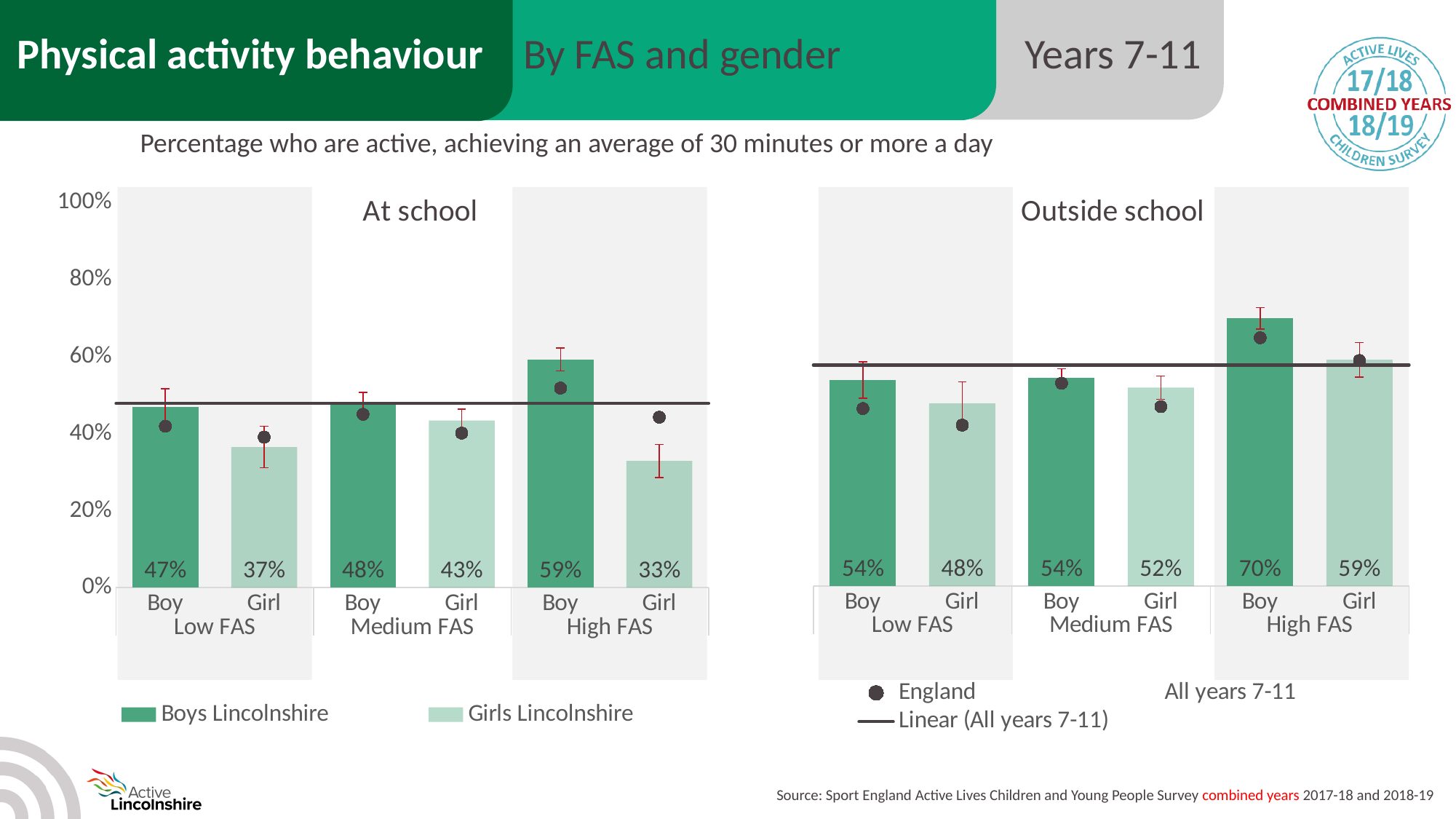
In the 'At school' chart, is the value for Medium FAS girls greater or less than 40%? greater What does the dark green bar colour represent in the legend? Boys Lincolnshire In the 'Outside school' chart, what is the difference between the Low FAS boys and Low FAS girls values? 6% What type of chart is the 'At school' chart? Bar chart In the 'Outside school' chart, which bar has the highest value? High FAS Boy In the 'Outside school' chart, which is larger: the Medium FAS boys value or the Medium FAS girls value? Medium FAS boys In the 'At school' chart, which bar has the lowest value? High FAS Girl In the 'At school' chart, what percentage of Low FAS boys in Lincolnshire are active? 47% In the 'Outside school' chart, what percentage of High FAS girls in Lincolnshire are active? 59% In the 'At school' chart, what is the difference between the High FAS boys and High FAS girls values? 26% How many bars are plotted in the 'Outside school' chart? 6 In the 'At school' chart, which bar has the highest value? High FAS Boy